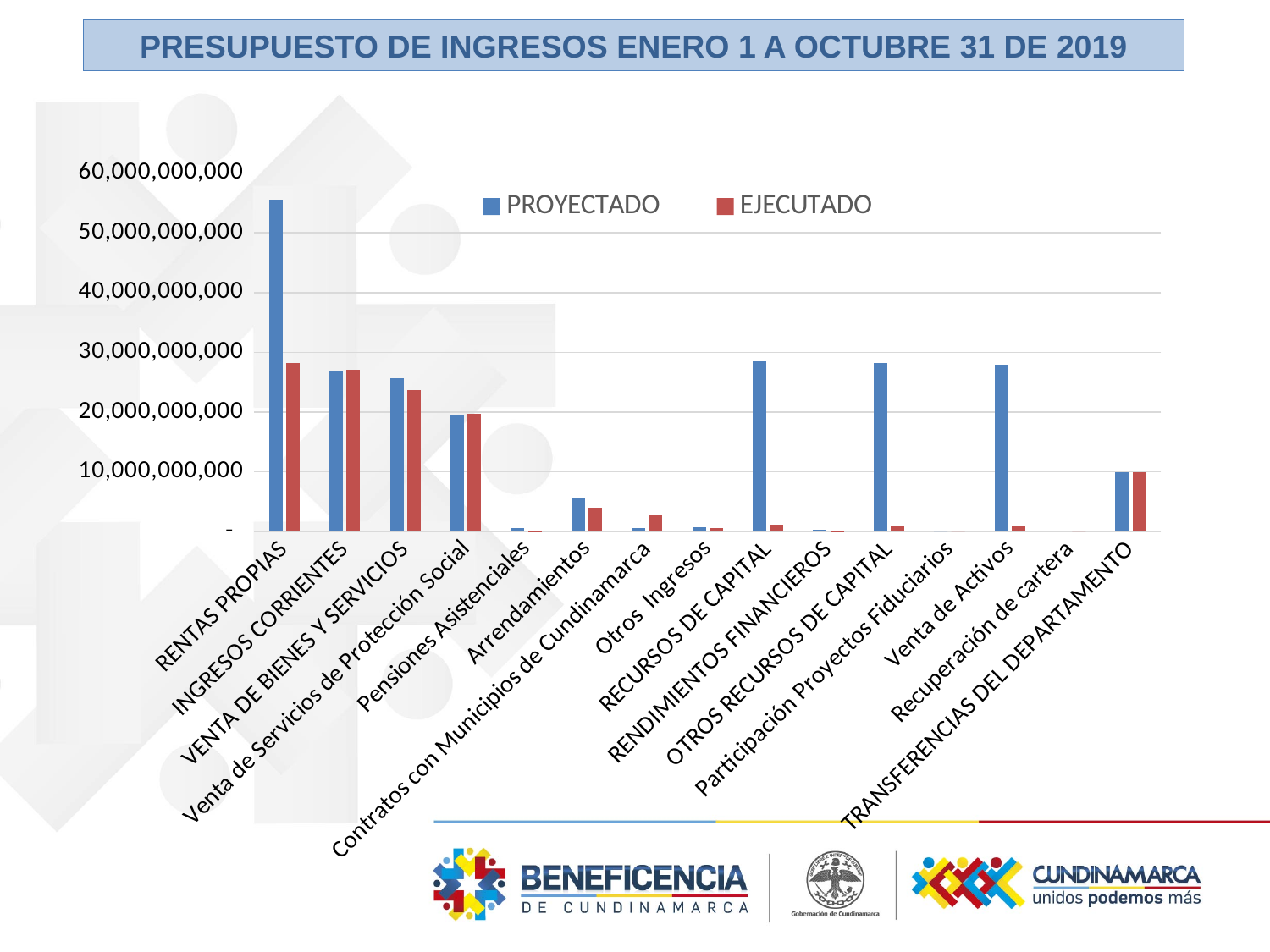
How many series does the legend list? 2 How many categories are shown on the x axis? 15 Which colour represents the EJECUTADO series? red Is the PROYECTADO value for VENTA DE BIENES Y SERVICIOS greater or less than 20,000,000,000? greater What is the title of the chart? PRESUPUESTO DE INGRESOS ENERO 1 A OCTUBRE 31 DE 2019 For RECURSOS DE CAPITAL, which is larger, the PROYECTADO or the EJECUTADO value? PROYECTADO Is the PROYECTADO value for Arrendamientos greater or less than 10,000,000,000? less Is the EJECUTADO value for RENTAS PROPIAS greater or less than 30,000,000,000? less What kind of chart is shown on the slide? bar chart For RENTAS PROPIAS, which is larger, the PROYECTADO or the EJECUTADO value? PROYECTADO Which category has the highest PROYECTADO value? RENTAS PROPIAS